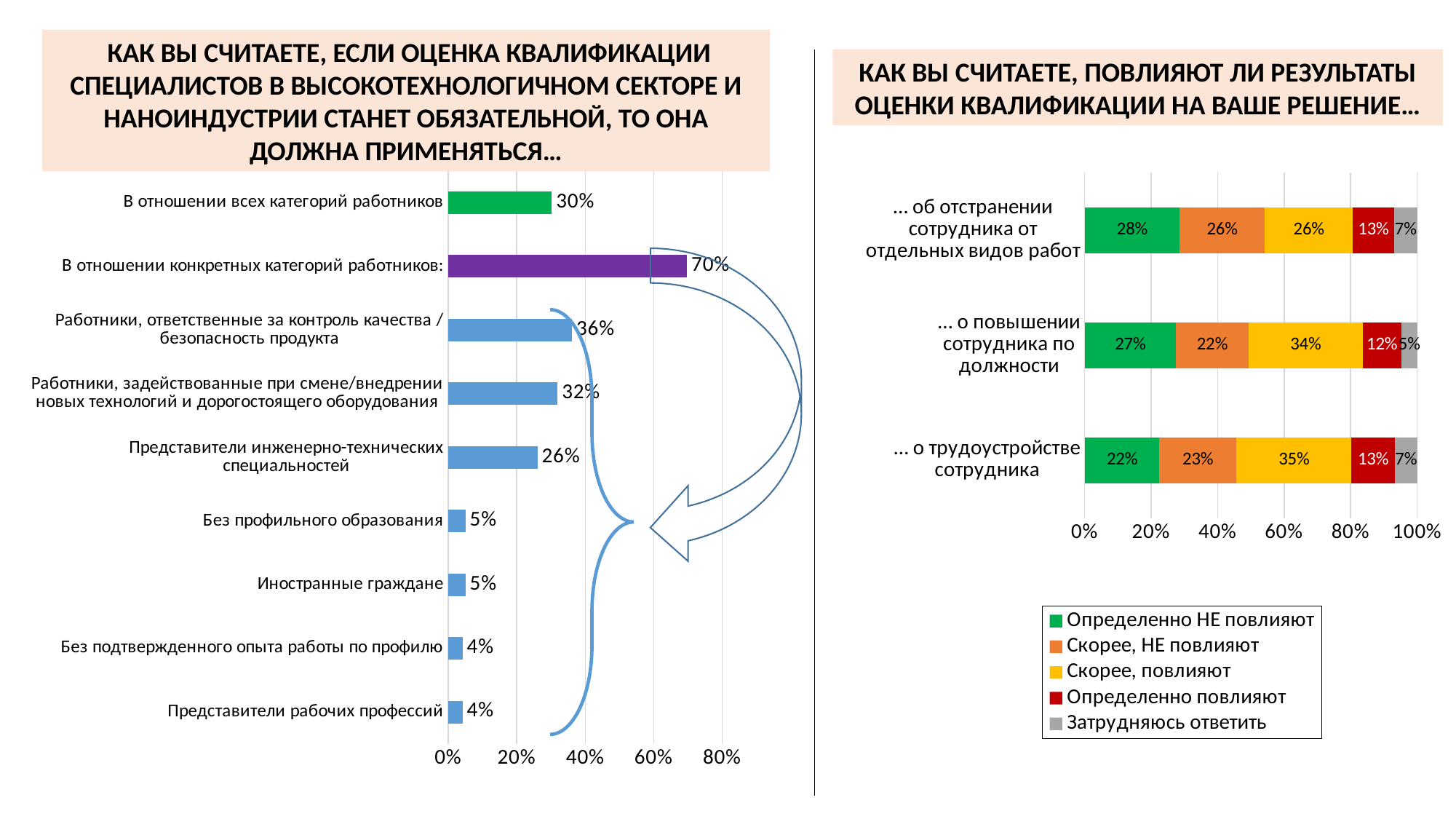
In the left chart, which is larger: "В отношении всех категорий работников" or "В отношении конкретных категорий работников"? В отношении конкретных категорий работников How many series does the legend of the right chart list? 5 In the right chart, what is the "Определенно НЕ повлияют" value for "… об отстранении сотрудника от отдельных видов работ"? 28% In the left chart, how many categories are plotted? 9 In the right chart, which colour represents "Определенно повлияют"? Red In the left chart, which category has the highest value? В отношении конкретных категорий работников In the right chart, what is the "Скорее, повлияют" value for "… о трудоустройстве сотрудника"? 35% In the left chart, what is the difference between "Работники, ответственные за контроль качества / безопасность продукта" and "Работники, задействованные при смене/внедрении новых технологий и дорогостоящего оборудования"? 4% In the left chart, what is the value for "Представители инженерно-технических специальностей"? 26% What type of chart is the left chart? Bar chart In the right chart, what is the total of the stacked bar for "… о повышении сотрудника по должности"? 100% In the left chart, what is the value for "В отношении конкретных категорий работников"? 70%